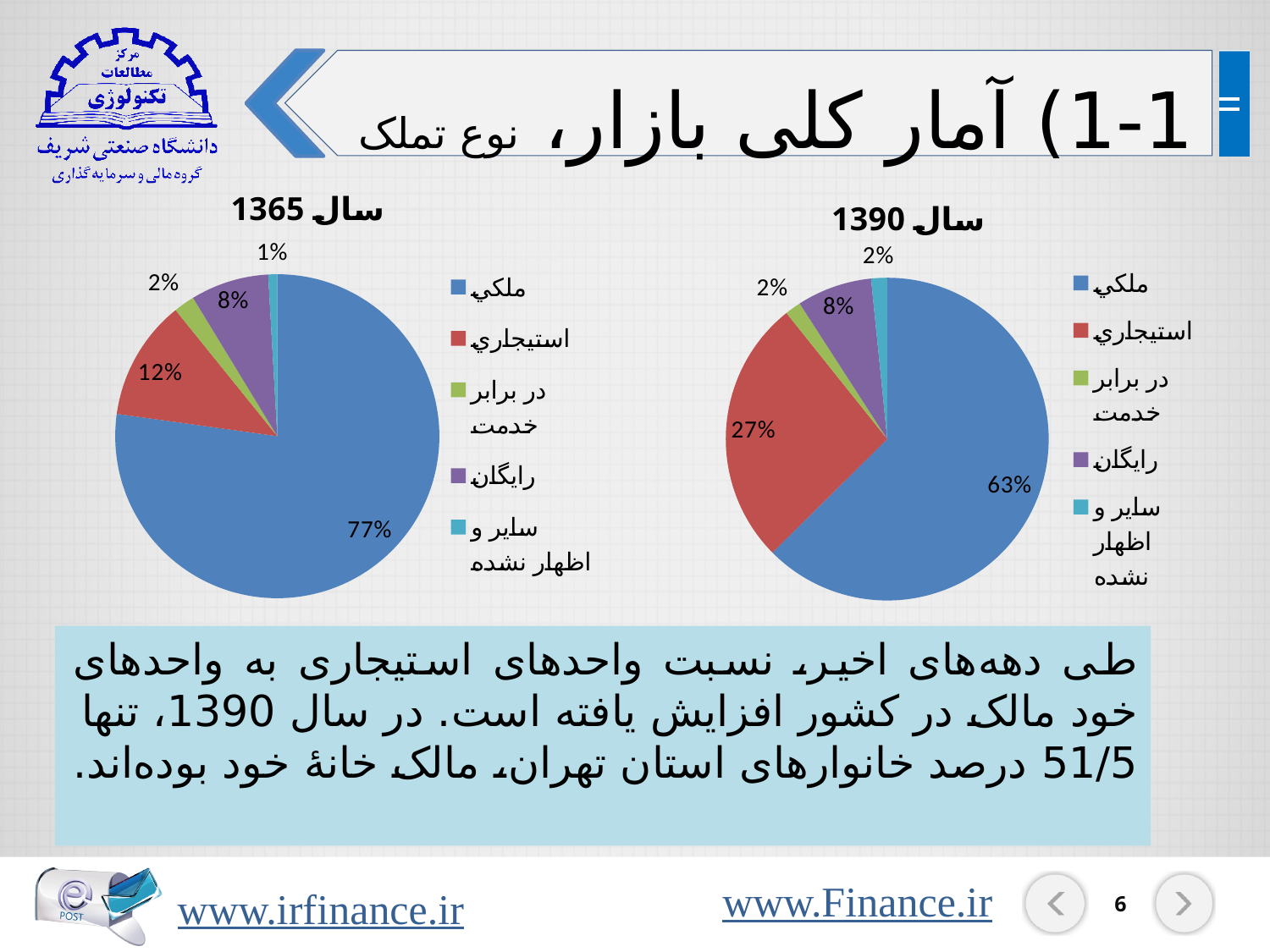
How many entries does the legend of the سال 1365 chart list? 5 In the pie chart titled سال 1365, which category has the largest slice? ملکي In the pie chart titled سال 1365, which category has the smallest slice? ساير و اظهار نشده In the pie chart titled سال 1390, what share is labelled for the رايگان slice? 8% Which is larger: the استيجاري share in the سال 1390 chart or the استيجاري share in the سال 1365 chart? سال 1390 In the pie chart titled سال 1390, what share is labelled for the استيجاري slice? 27% In the pie chart titled سال 1365, what share is labelled for the ملکي slice? 77% What type of chart is the chart titled سال 1390? pie chart In the pie chart titled سال 1365, what share is labelled for the استيجاري slice? 12% How many slices does the pie chart titled سال 1390 have? 5 In the pie chart titled سال 1390, what share is labelled for the ملکي slice? 63% What is the difference between the ملکي share in the سال 1365 chart and the ملکي share in the سال 1390 chart? 14%